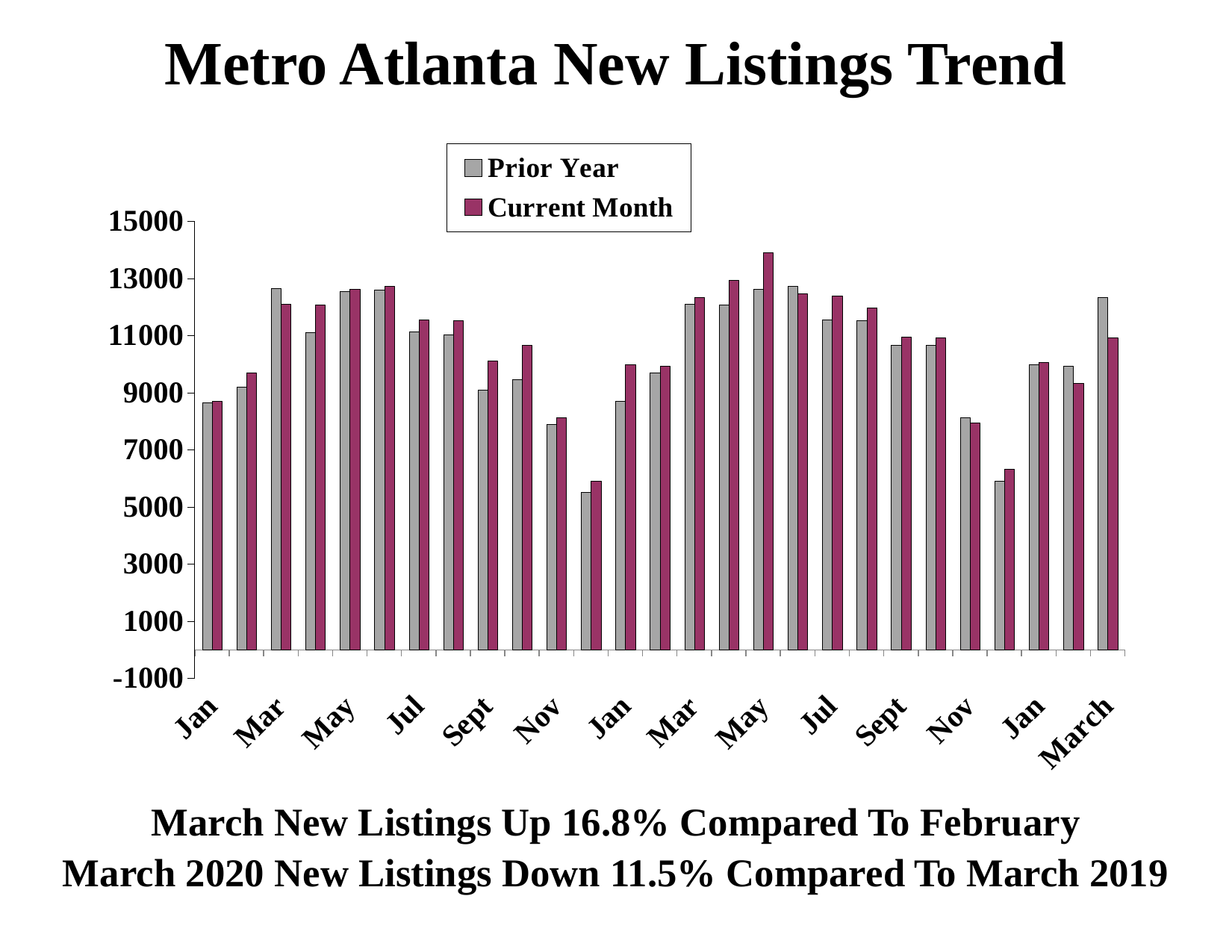
Which series is drawn in gray in the legend? Prior Year For the second May, which is larger: Prior Year or Current Month? Current Month Which month has the lowest Current Month value? Dec (first year) Is the Prior Year value for the final March greater or less than 11000? greater For the final March, which is larger: Prior Year or Current Month? Prior Year How many series does the legend list? 2 What kind of chart is shown on the slide? bar chart Which month has the highest Current Month value? May (second year) What is the title of the chart? Metro Atlanta New Listings Trend Do the Current Month values rise or fall from the first Jan to the first Mar? rise Is the Current Month value for the final March greater or less than 9000? greater Is the Prior Year value for the first Dec greater or less than 7000? less